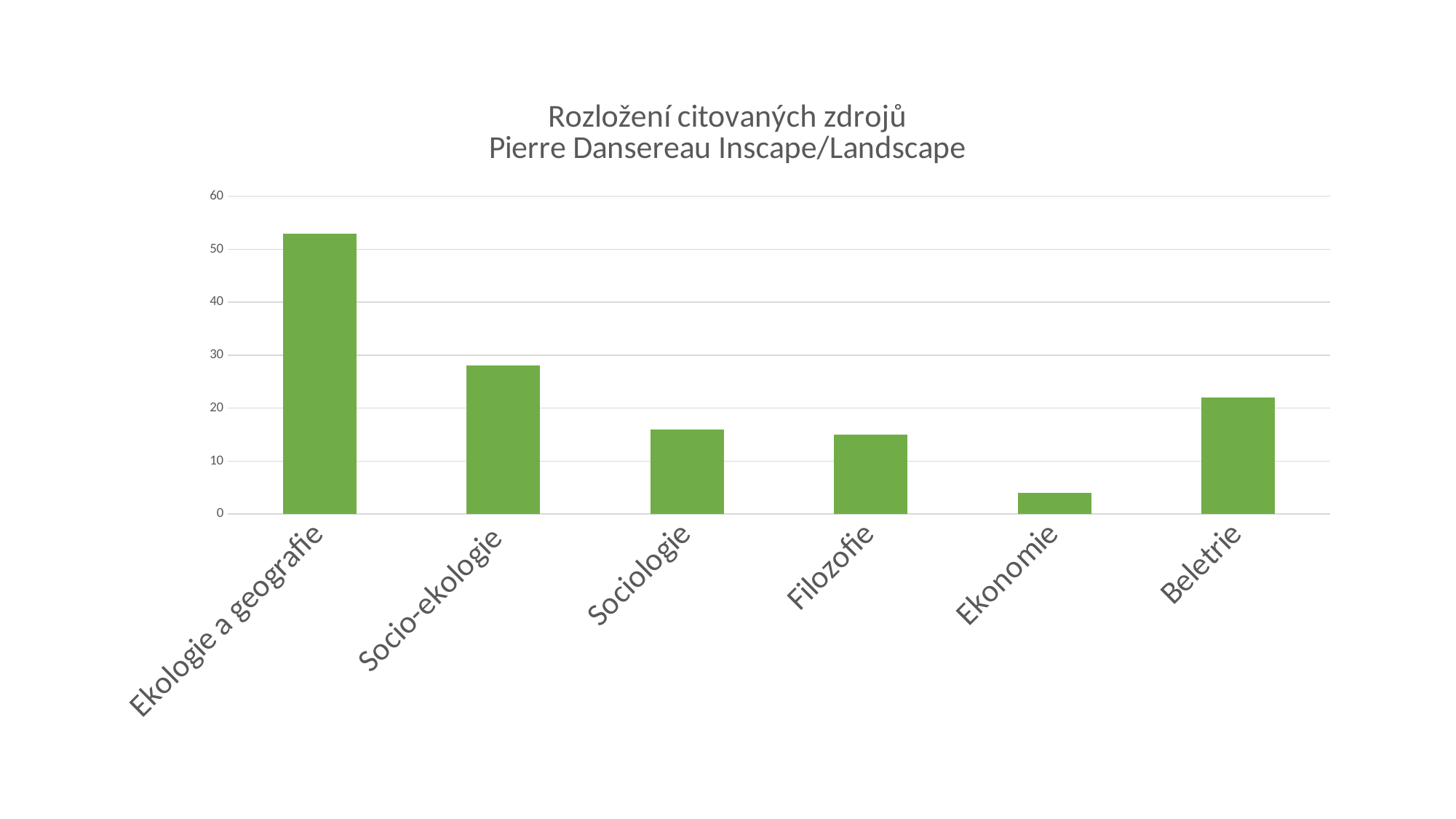
Is the value for Ekologie a geografie greater or less than 50? greater What is the title of the chart? Rozložení citovaných zdrojů Pierre Dansereau Inscape/Landscape Is the value for Ekonomie greater or less than 10? less Which is larger, the value for Socio-ekologie or the value for Beletrie? Socio-ekologie Is the value for Socio-ekologie greater or less than 30? less Which category has the lowest bar in the chart? Ekonomie Which category has the highest bar in the chart? Ekologie a geografie Which is larger, the value for Filozofie or the value for Ekonomie? Filozofie How many categories are shown on the x axis of the chart? 6 What kind of chart is shown on the slide? bar chart